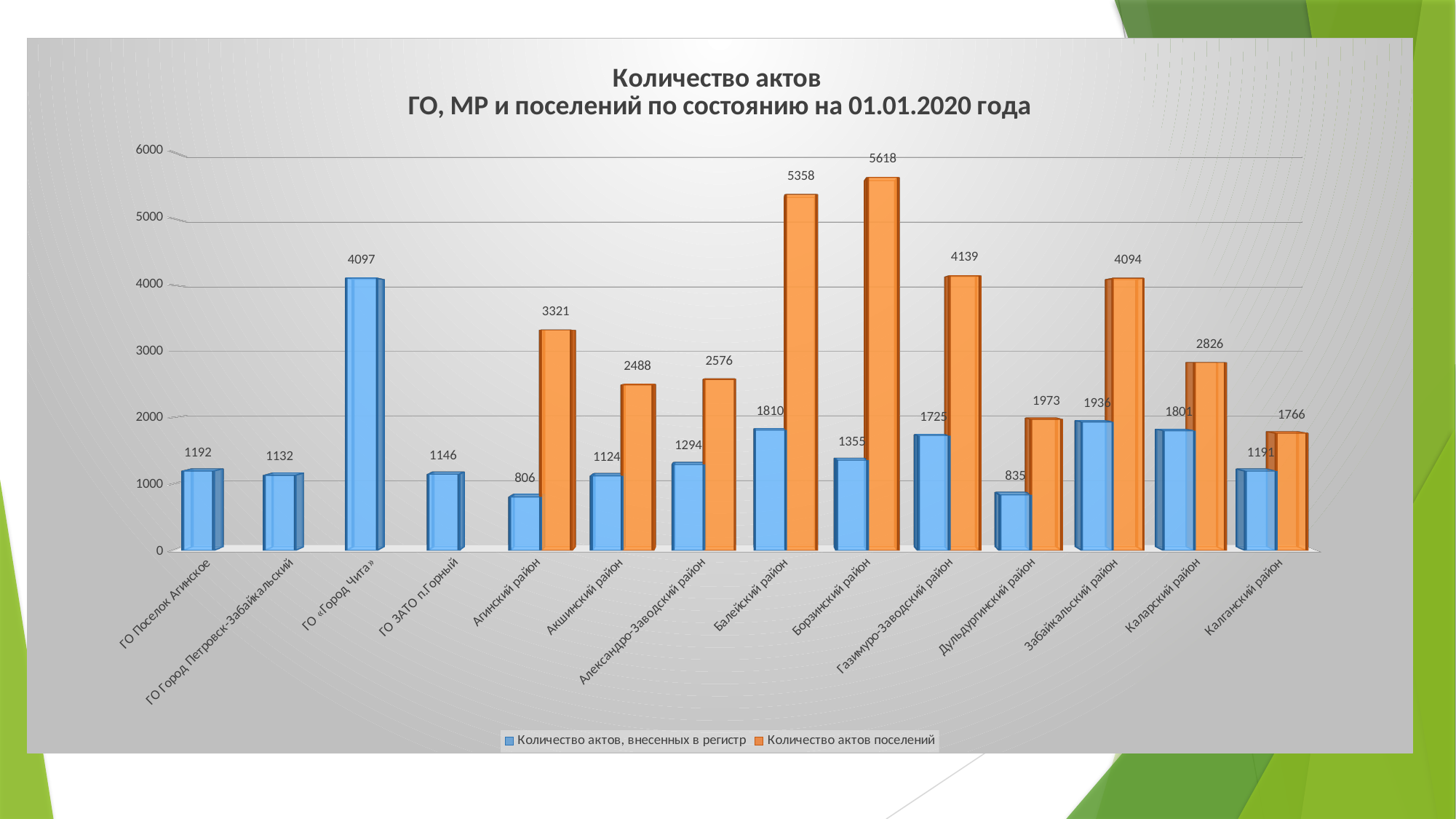
What kind of chart is shown on the slide? Bar chart What is the value of 'Количество актов поселений' for Дульдургинский район? 1973 What is the difference between the 'Количество актов поселений' values for Газимуро-Заводский район and Забайкальский район? 45 Which category has the highest value for 'Количество актов поселений'? Борзинский район Which has a larger value for 'Количество актов, внесенных в регистр': Забайкальский район or Каларский район? Забайкальский район How many series does the legend list? 2 Which category has the highest value for 'Количество актов, внесенных в регистр'? ГО «Город Чита» Which category has the lowest value for 'Количество актов, внесенных в регистр'? Агинский район What is the value of 'Количество актов поселений' for Борзинский район? 5618 For Балейский район, what is the difference between 'Количество актов поселений' and 'Количество актов, внесенных в регистр'? 3548 How many categories are shown on the x axis? 14 What is the value of 'Количество актов, внесенных в регистр' for ГО «Город Чита»? 4097